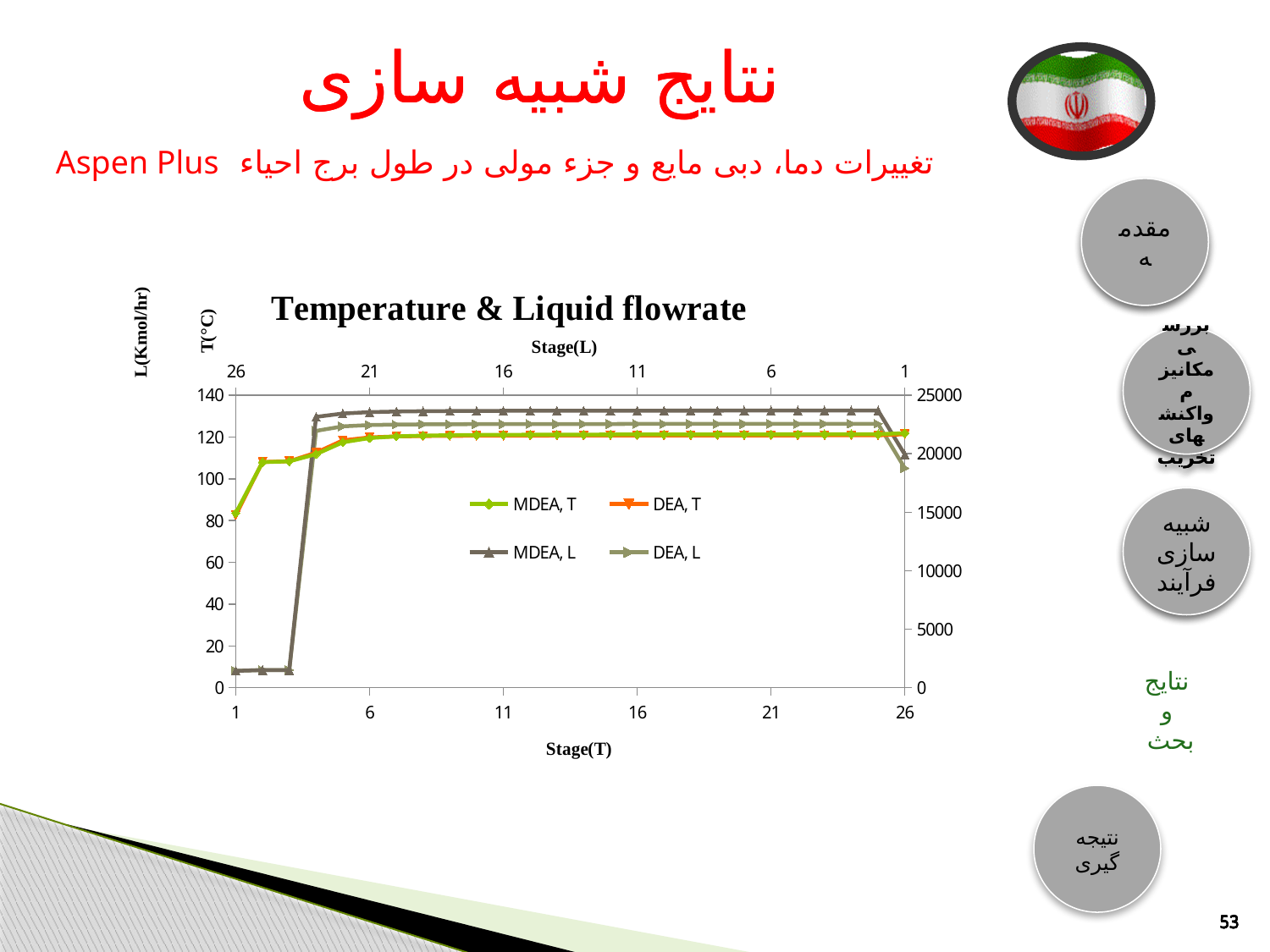
Is the plateau value of DEA, L on the right axis greater or less than 20000? greater What kind of chart is shown on the slide? line chart Does the MDEA, T series rise or fall between stage 1 and stage 6 on the Stage(T) axis? rise What is the highest stage number shown on the Stage(T) axis? 26 What is the title of the chart? Temperature & Liquid flowrate Is the value of MDEA, T at stage 16 on the Stage(T) axis greater or less than 100? greater Which series are listed in the chart legend? MDEA, T; DEA, T; MDEA, L; DEA, L Is the plateau value of MDEA, L on the right axis greater or less than 20000? greater How many series does the chart legend list? 4 What is the maximum value shown on the right-hand L(Kmol/hr) axis? 25000 Which series has the higher plateau on the right axis, MDEA, L or DEA, L? MDEA, L